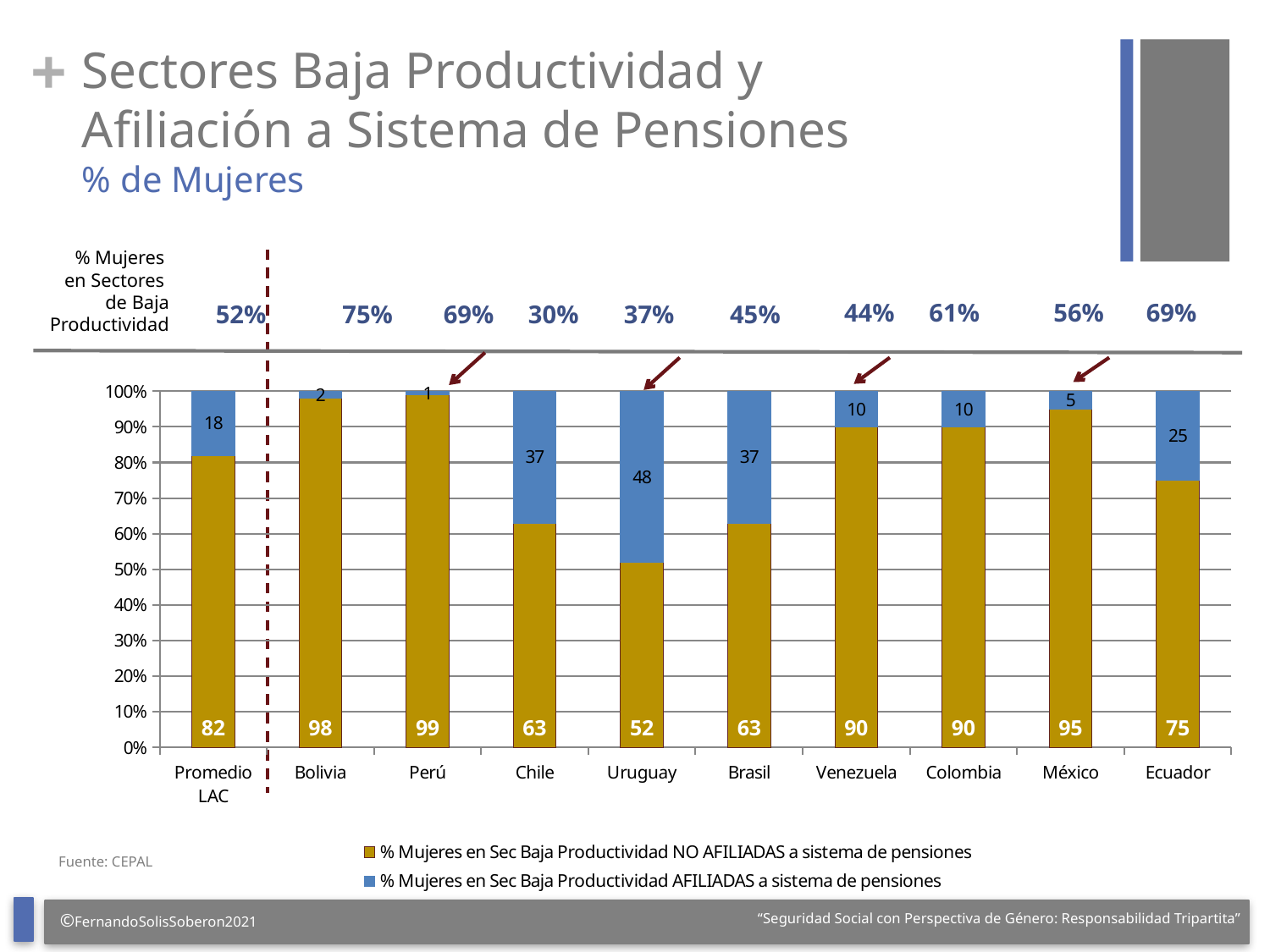
What is the total of the stacked bar for México? 100 Which is larger, the AFILIADAS value for Promedio LAC or for Venezuela? Promedio LAC How many series does the chart legend list? 2 What is the value for Chile in the series '% Mujeres en Sec Baja Productividad AFILIADAS a sistema de pensiones'? 37 What is the difference between the NO AFILIADAS values for Bolivia and Ecuador? 23 How many countries or categories are shown on the x axis of the chart? 10 Which category has the lowest value in the series '% Mujeres en Sec Baja Productividad NO AFILIADAS a sistema de pensiones'? Uruguay What is the value for Ecuador in the series '% Mujeres en Sec Baja Productividad AFILIADAS a sistema de pensiones'? 25 Which category has the highest value in the series '% Mujeres en Sec Baja Productividad AFILIADAS a sistema de pensiones'? Uruguay Which category has the highest value in the series '% Mujeres en Sec Baja Productividad NO AFILIADAS a sistema de pensiones'? Perú What is the value for Uruguay in the series '% Mujeres en Sec Baja Productividad NO AFILIADAS a sistema de pensiones'? 52 What kind of chart is shown on the slide? Stacked bar chart